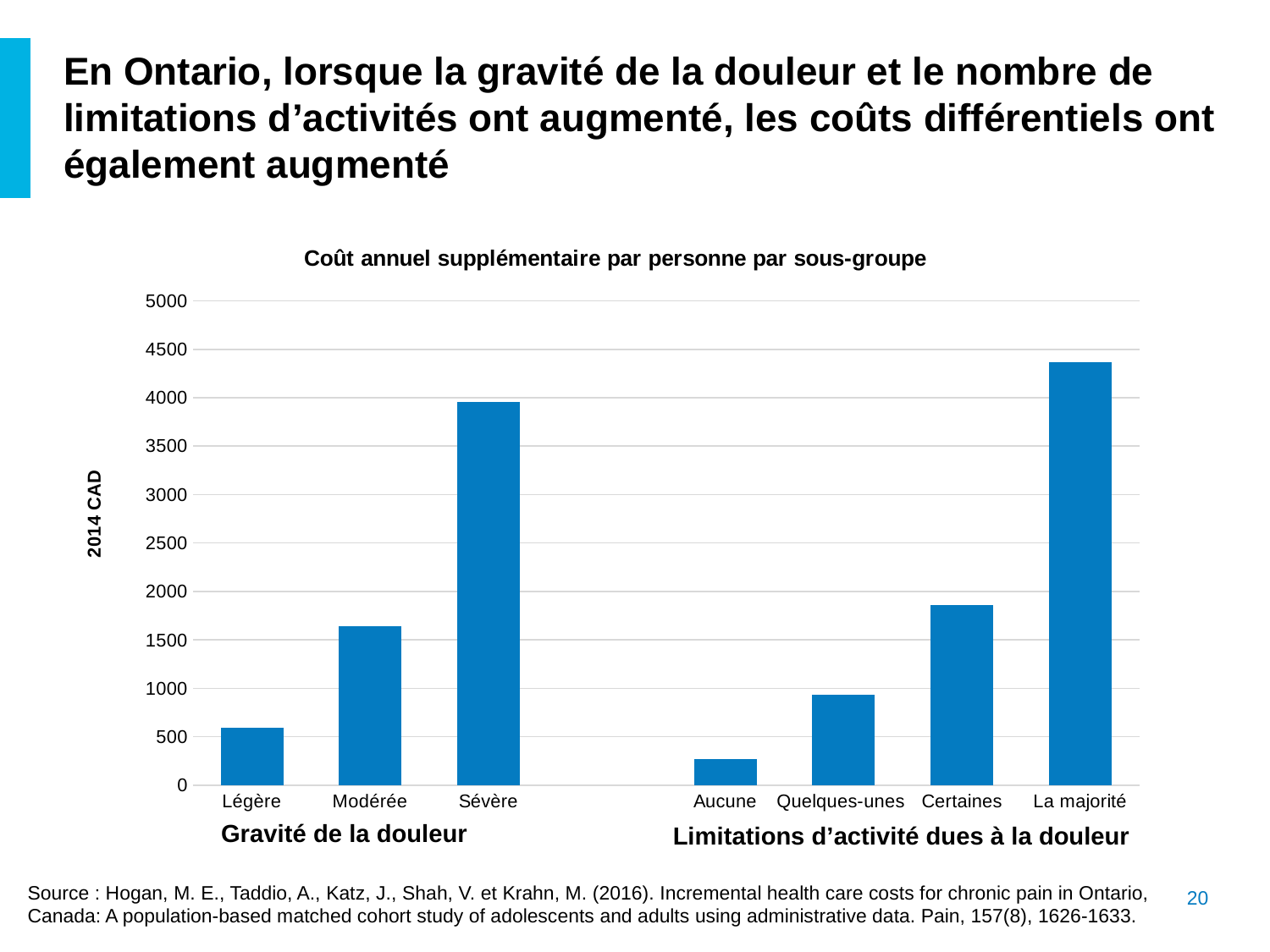
Do the values rise or fall from Aucune to La majorité along the x axis? rise What kind of chart is shown on the slide? bar chart Is the value for La majorité greater or less than 4000? greater Which category has the lowest bar in the chart? Aucune Among the 'Gravité de la douleur' categories, which has the highest value? Sévère Which is larger, the value for Modérée or the value for Certaines? Certaines What is the label on the vertical axis of the chart? 2014 CAD Is the value for Sévère greater or less than 3500? greater How many bars are plotted in the chart? 7 Is the value for Légère greater or less than 1000? less What is the title of the chart? Coût annuel supplémentaire par personne par sous-groupe Which category has the highest bar in the chart? La majorité